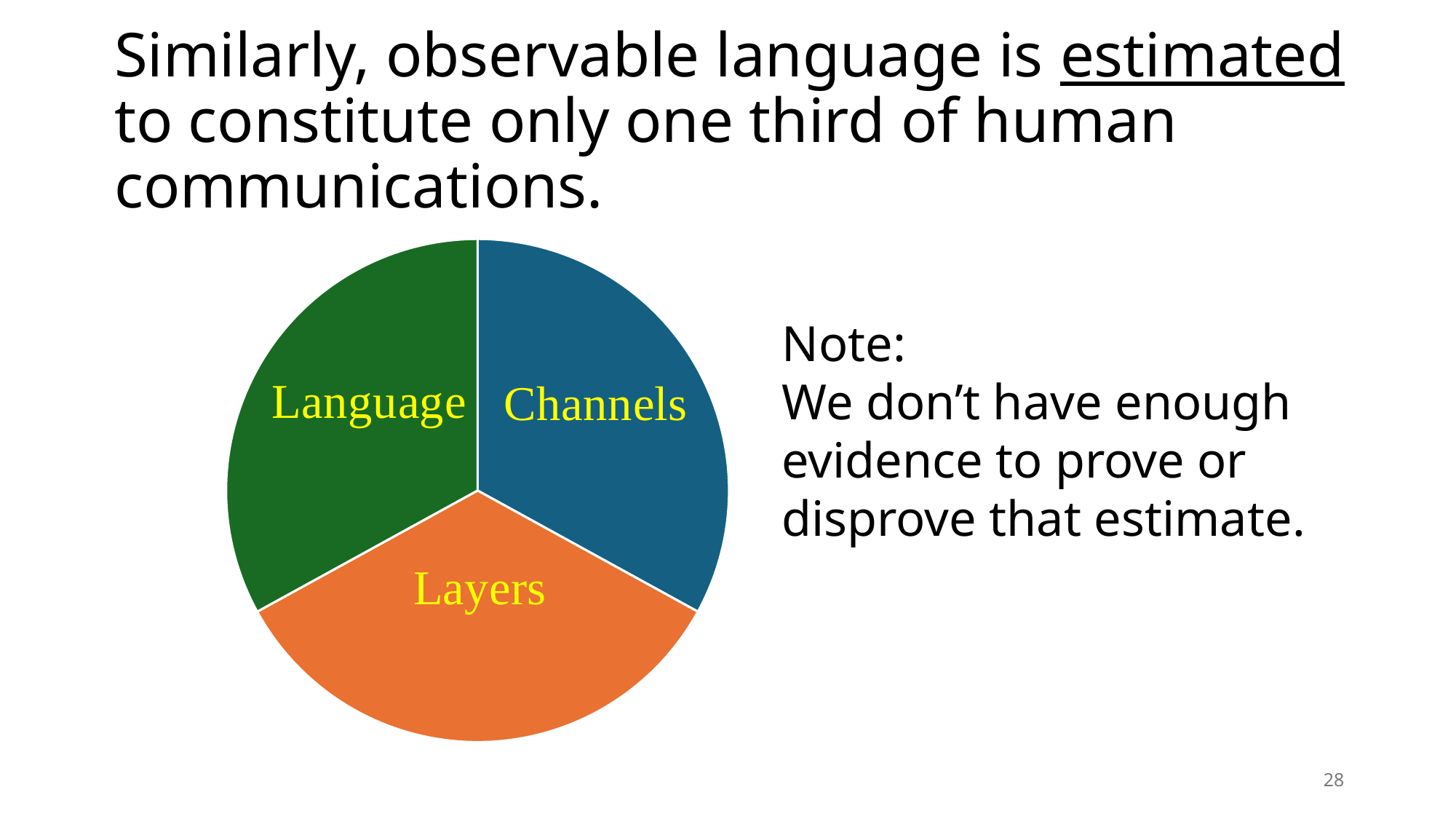
How many slices does the pie chart have? 3 What kind of chart is shown on the slide? pie chart Are the three slices of the pie chart roughly equal in size? yes What colour is the Language slice in the pie chart? green Which slice of the pie chart is orange? Layers Which slice is at the bottom of the pie chart? Layers Which slice of the pie chart is blue? Channels What are the labels of the three slices in the pie chart? Language, Channels, Layers